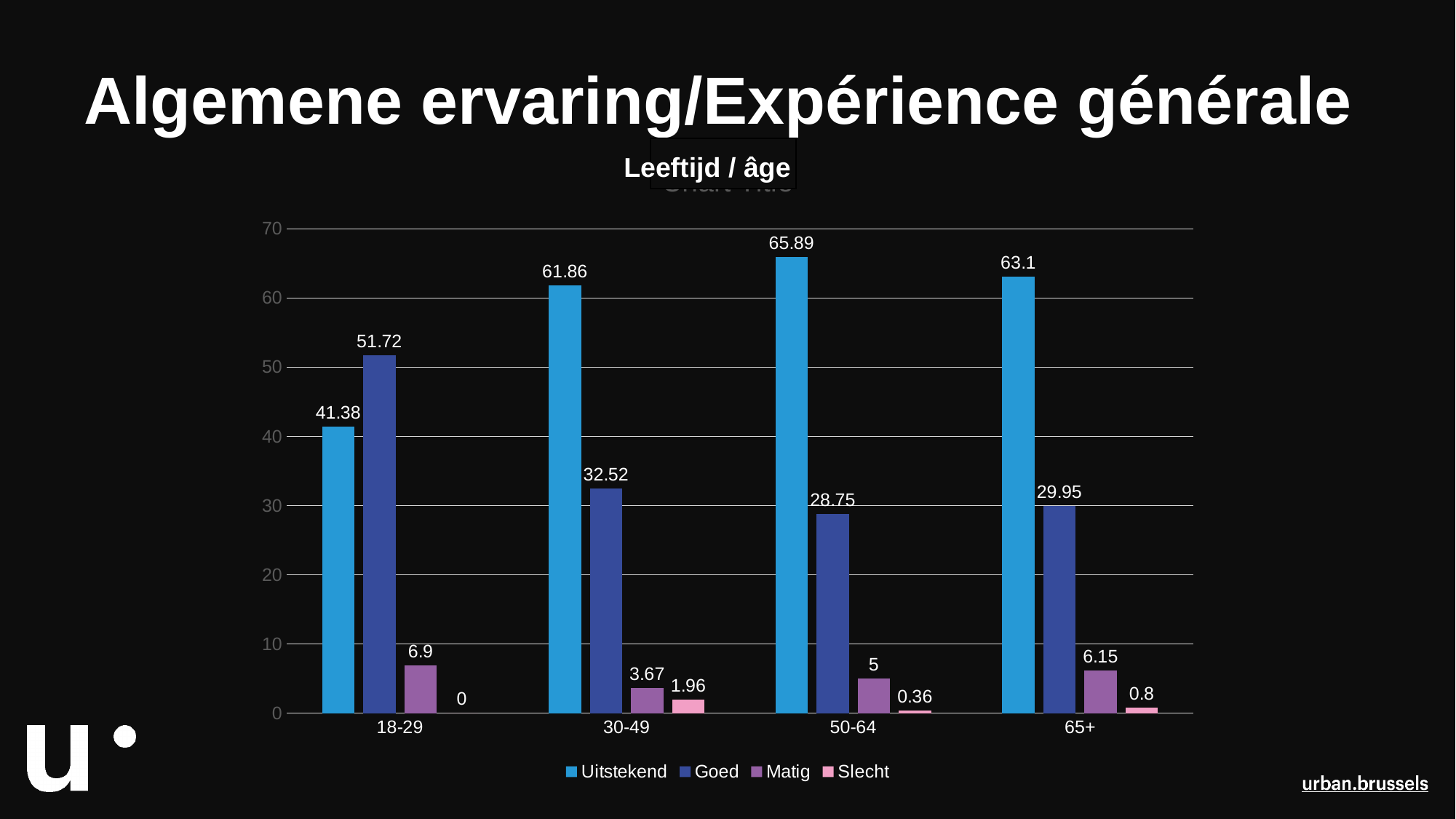
Which age group has the lowest value for Slecht? 18-29 What is the value for Goed in the 18-29 age group? 51.72 What is the value for Slecht in the 30-49 age group? 1.96 What kind of chart is shown on the slide? Bar chart Which age group has the highest value for Uitstekend? 50-64 How many age groups are shown on the x axis? 4 What is the title shown above the chart? Leeftijd / âge Which is larger in the 18-29 age group, Uitstekend or Goed? Goed What is the difference between the Uitstekend and Goed values in the 30-49 age group? 29.34 What is the value for Uitstekend in the 50-64 age group? 65.89 How many series does the legend list? 4 What is the value for Matig in the 65+ age group? 6.15